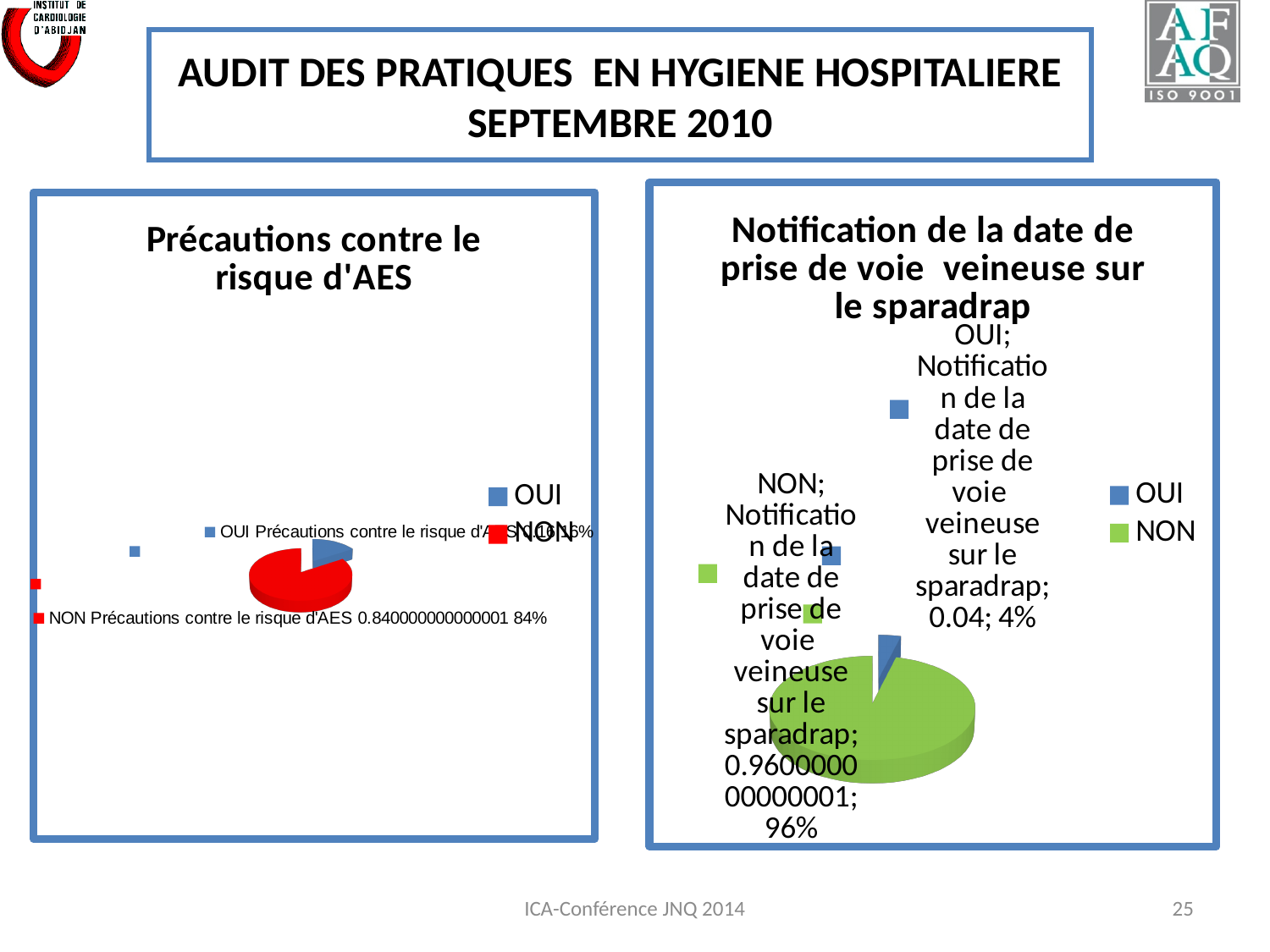
What kind of chart is the 'Notification de la date de prise de voie veineuse sur le sparadrap' chart? pie chart In the 'Précautions contre le risque d'AES' chart, what percentage is shown for NON? 84% In the 'Notification de la date de prise de voie veineuse sur le sparadrap' chart, what percentage is shown for OUI? 4% In the 'Notification de la date de prise de voie veineuse sur le sparadrap' chart, which category has the smallest share? OUI In the 'Précautions contre le risque d'AES' chart, what colour is the NON slice? red In the 'Notification de la date de prise de voie veineuse sur le sparadrap' chart, how many slices does the pie have? 2 In the 'Notification de la date de prise de voie veineuse sur le sparadrap' chart, which category has the largest share? NON In the 'Précautions contre le risque d'AES' chart, which slice is larger, OUI or NON? NON In the 'Précautions contre le risque d'AES' chart, how many entries does the legend list? 2 In the 'Notification de la date de prise de voie veineuse sur le sparadrap' chart, what percentage is shown for NON? 96% In the 'Notification de la date de prise de voie veineuse sur le sparadrap' chart, what is the difference in percentage points between NON and OUI? 92 What kind of chart is the 'Précautions contre le risque d'AES' chart? pie chart